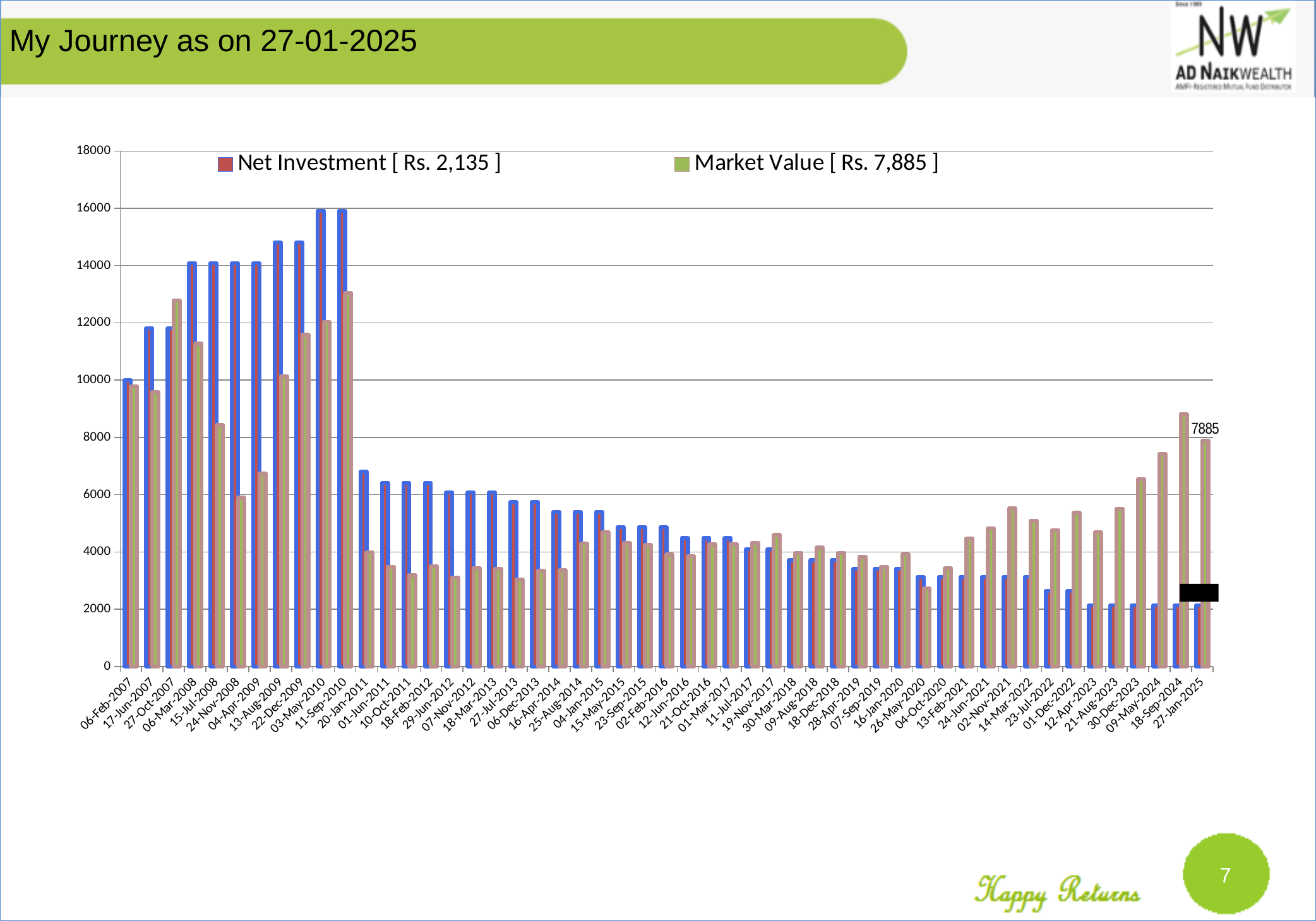
On which date is the Market Value lowest? 26-May-2020 Is the Market Value for 01-Jun-2011 greater or less than 4000? less On 06-Mar-2008, which is larger, Net Investment or Market Value? Net Investment How many series does the chart legend list? 2 Is the Market Value for 18-Sep-2024 greater or less than 8000? greater On 27-Jan-2025, which is larger, Net Investment or Market Value? Market Value What type of chart is shown on the slide? bar chart Is the Net Investment for 13-Aug-2009 greater or less than 14000? greater Does the Net Investment rise or fall from 20-Jan-2011 to 27-Jan-2025? fall What is the Market Value on 27-Jan-2025? 7885 What amount does the legend show for Market Value? Rs. 7,885 What amount does the legend show for Net Investment? Rs. 2,135